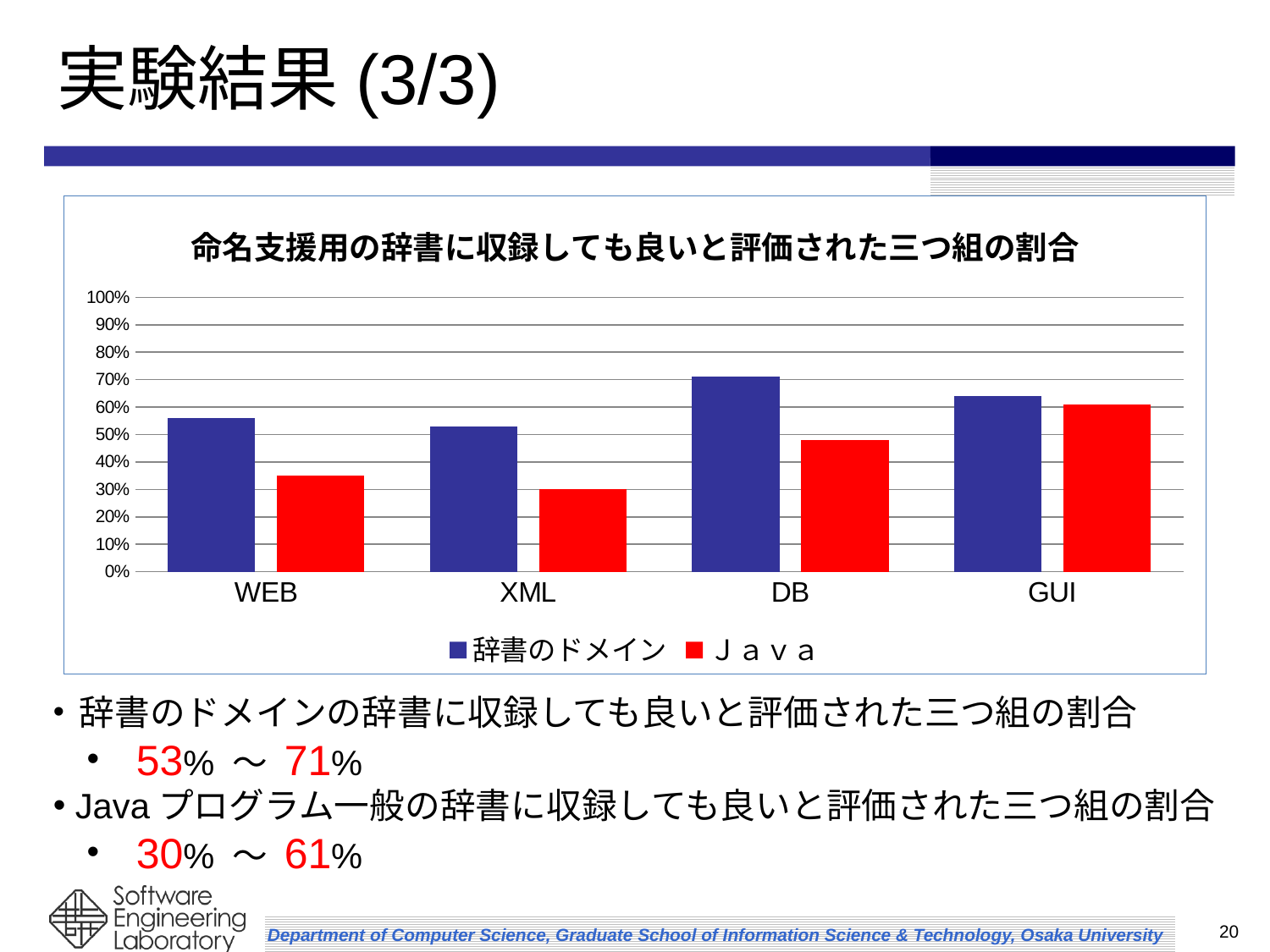
For the DB category, which series has the larger value, 辞書のドメイン or Java? 辞書のドメイン Is the Java value for GUI greater or less than 50%? greater For the 辞書のドメイン series, which category has the highest value? DB Is the Java value for XML greater or less than 40%? less Which series is shown in red in the chart? Java How many series does the chart's legend list? 2 How many categories are shown on the x axis of the chart? 4 What kind of chart is shown on the slide? bar chart Is the 辞書のドメイン value for DB greater or less than 60%? greater What is the title of the chart? 命名支援用の辞書に収録しても良いと評価された三つ組の割合 For the Java series, which category has the lowest value? XML For the Java series, which category has the highest value? GUI